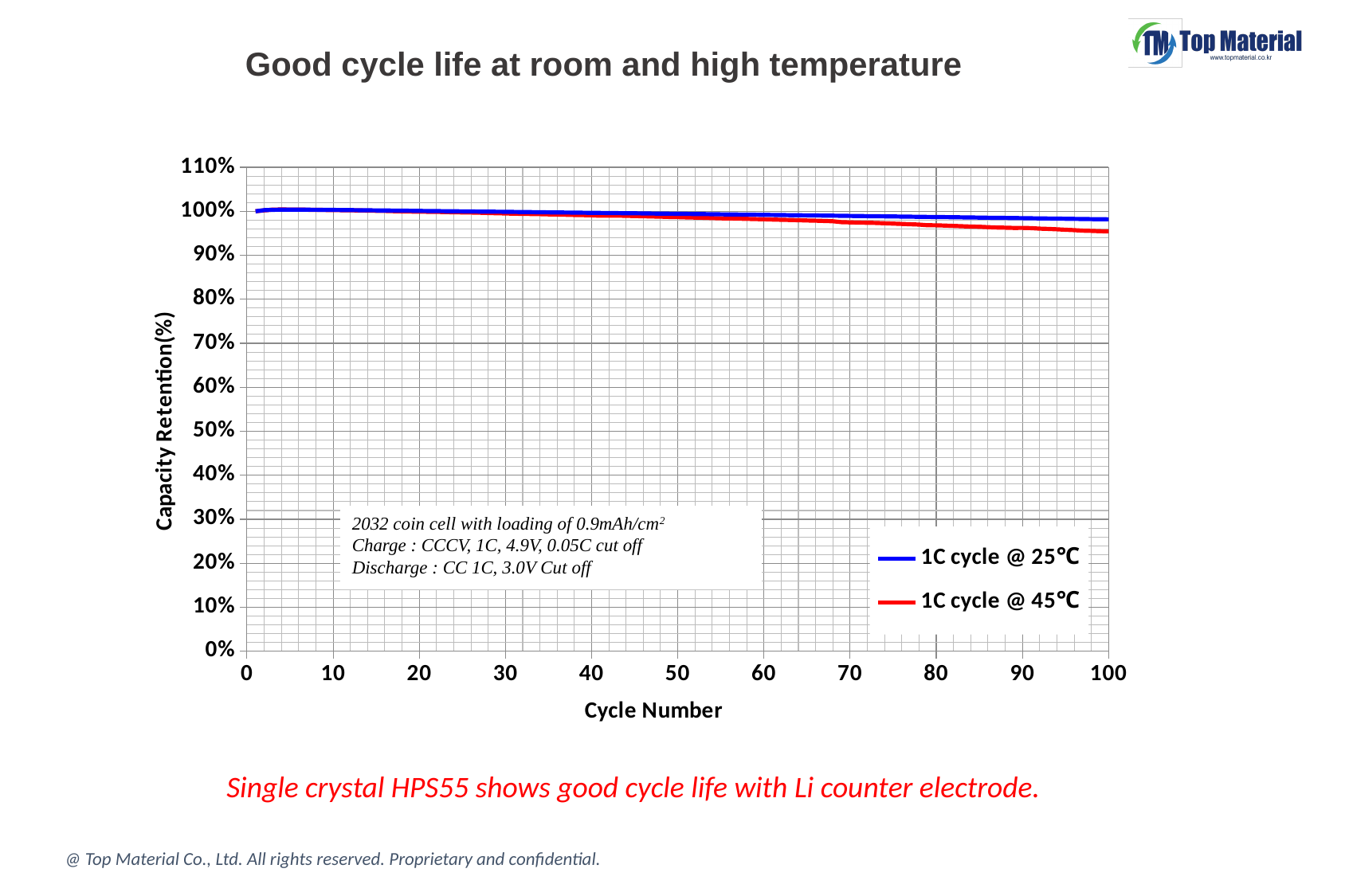
What are the two series named in the legend? 1C cycle @ 25℃ and 1C cycle @ 45℃ What is the title of the chart's x axis? Cycle Number At cycle 100, which series has the higher capacity retention, 1C cycle @ 25℃ or 1C cycle @ 45℃? 1C cycle @ 25℃ What kind of chart is shown on the slide? line chart Is the capacity retention for 1C cycle @ 45℃ at cycle 100 greater or less than 90%? greater How many labelled tick marks are there on the x axis? 11 How many series does the legend list? 2 Do the values for the 1C cycle @ 45℃ series rise or fall as the cycle number increases? fall Is the capacity retention for 1C cycle @ 45℃ at cycle 100 greater or less than 100%? less Which series shows the lowest capacity retention at the end of the test (cycle 100)? 1C cycle @ 45℃ Do the values for the 1C cycle @ 25℃ series rise or fall as the cycle number increases? fall Is the capacity retention for 1C cycle @ 25℃ at cycle 100 greater or less than 90%? greater